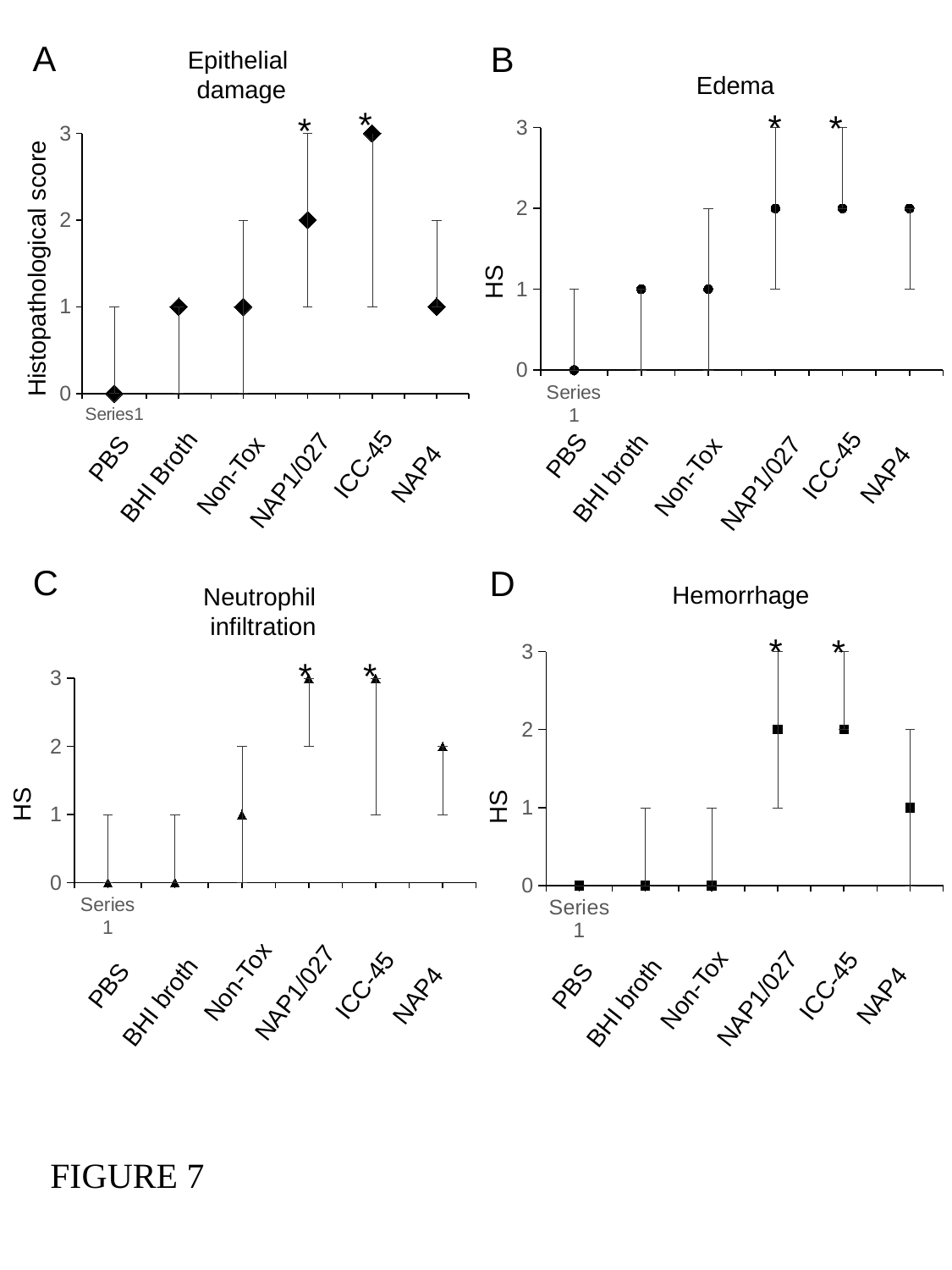
What is the y-axis label of the Epithelial damage chart (A)? Histopathological score In the Neutrophil infiltration chart (C), what is the difference between the HS values for NAP1/027 and Non-Tox? 2 How many categories are shown on the x axis of the Hemorrhage chart (D)? 6 In the Hemorrhage chart (D), what is the HS value for NAP1/027? 2 In the Edema chart (B), which category has the lowest HS value? PBS What is the title of the chart labelled B? Edema In the Epithelial damage chart (A), what is the score for NAP1/027? 2 In the Hemorrhage chart (D), which is larger, the HS value for ICC-45 or for NAP4? ICC-45 In the Epithelial damage chart (A), what is the histopathological score for ICC-45? 3 In the Edema chart (B), what is the HS value for NAP4? 2 In the Neutrophil infiltration chart (C), what is the HS value for NAP4? 2 In the Epithelial damage chart (A), which category has the highest score? ICC-45